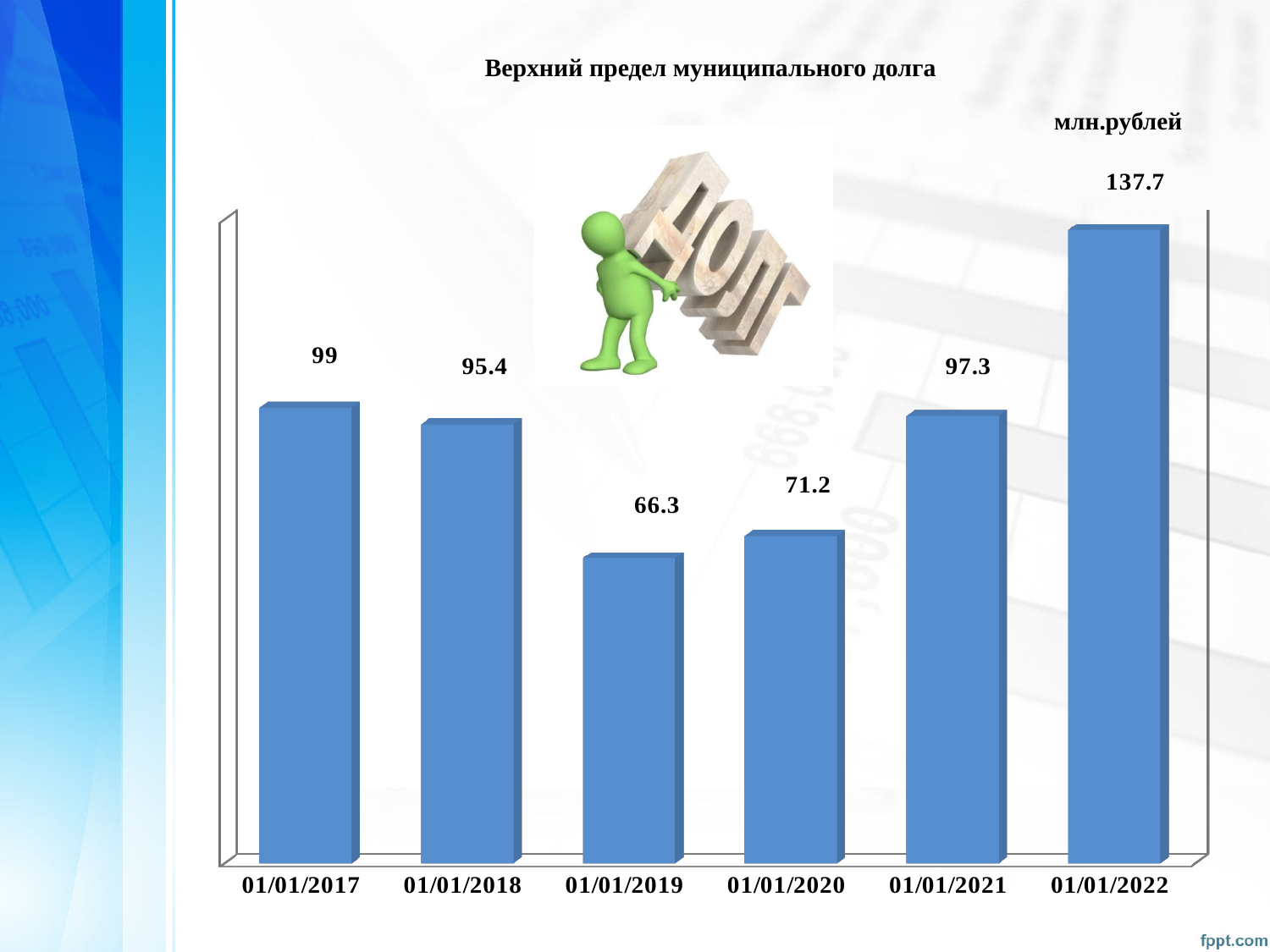
What is the value for 01/01/2019? 66.3 Which date has the lowest value? 01/01/2019 How many bars are shown in the chart? 6 What is the value for 01/01/2020? 71.2 What is the value for 01/01/2017? 99 What kind of chart is shown on the slide? bar chart What is the difference between the values for 01/01/2022 and 01/01/2021? 40.4 What is the difference between the values for 01/01/2017 and 01/01/2018? 3.6 Which is larger, the value for 01/01/2018 or the value for 01/01/2021? 01/01/2021 What is the value for 01/01/2022? 137.7 What is the title of the chart? Верхний предел муниципального долга Which date has the highest value? 01/01/2022